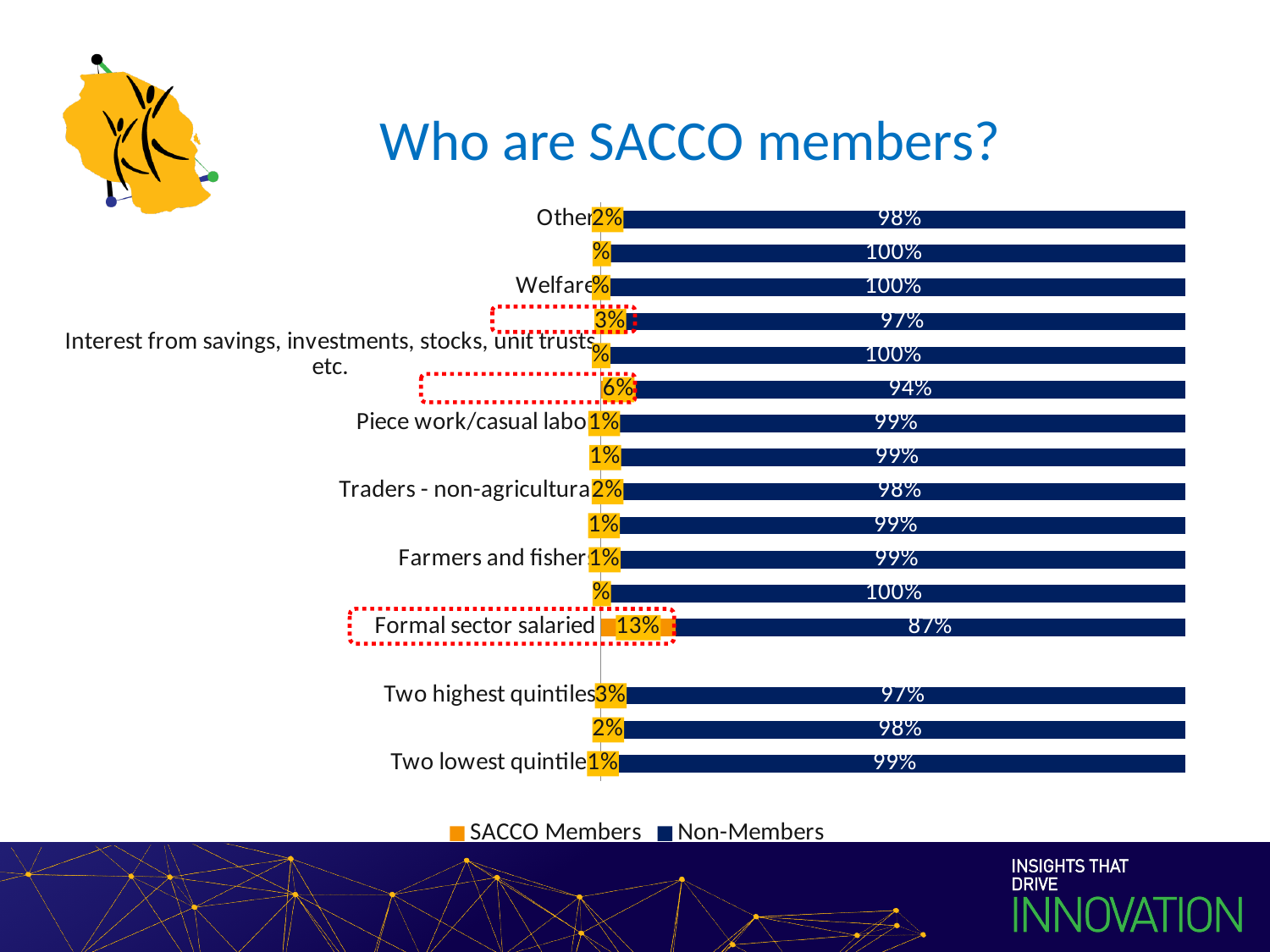
Which category has the highest share of SACCO Members? Formal sector salaried What type of chart is shown on the slide? Bar chart What is the SACCO Members value for Traders - non-agricultural? 2% What is the Non-Members value for the Formal sector salaried category? 87% Which category has the lowest Non-Members value? Formal sector salaried What percentage of the Formal sector salaried group are SACCO Members? 13% What is the Non-Members value for Welfare? 100% What is the SACCO Members value for Two highest quintiles? 3% What is the difference between the Non-Members and SACCO Members values for Formal sector salaried? 74% What is the Non-Members value for Two lowest quintile? 99% Which is larger for Two highest quintiles: the SACCO Members value or the Non-Members value? Non-Members How many series does the legend list? 2